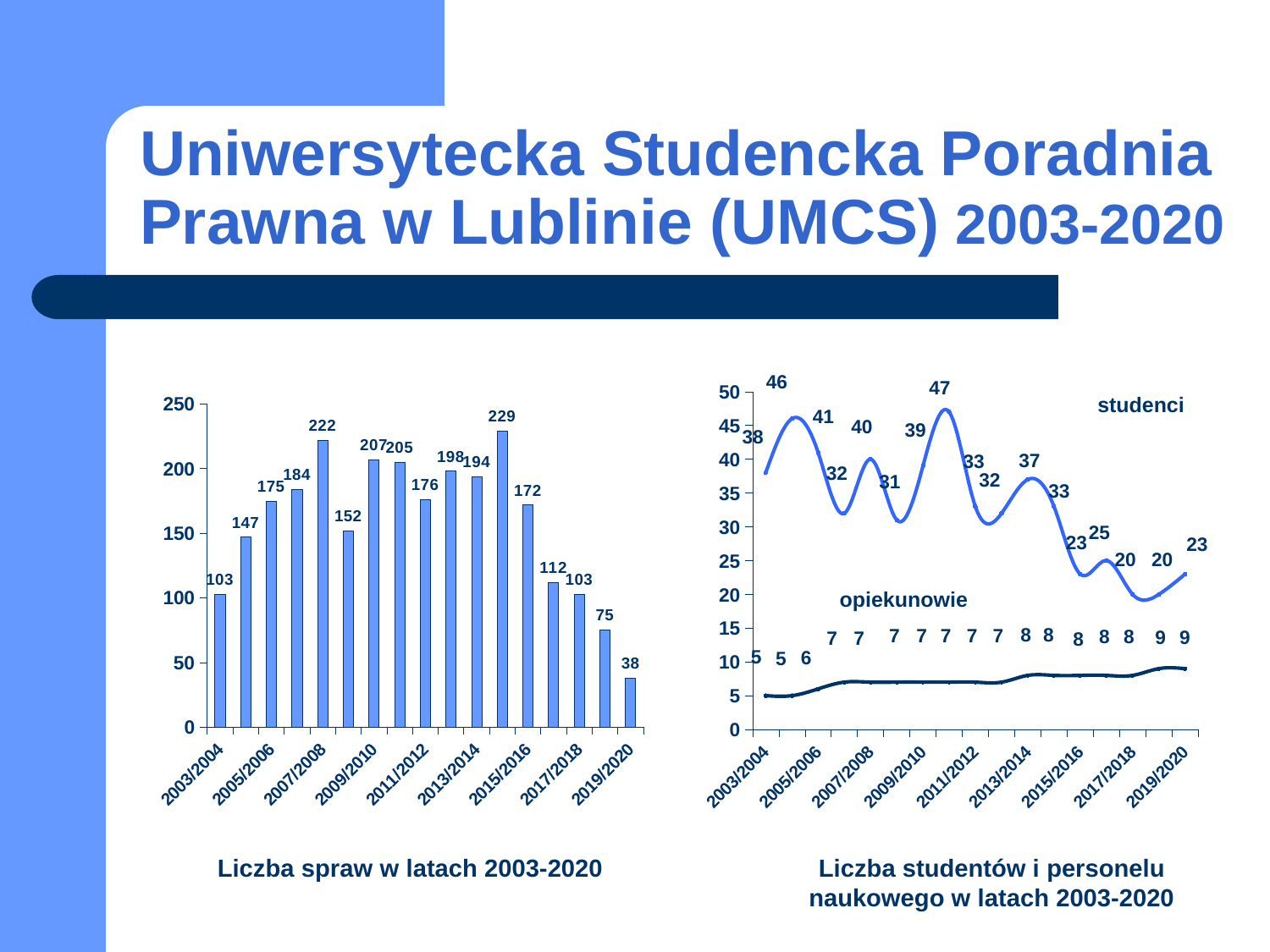
In the chart 'Liczba spraw w latach 2003-2020', what is the value for 2007/2008? 222 How many series are plotted in the chart 'Liczba studentów i personelu naukowego w latach 2003-2020'? 2 In the chart 'Liczba studentów i personelu naukowego w latach 2003-2020', what is the value of 'studenci' for 2003/2004? 38 In the chart 'Liczba spraw w latach 2003-2020', what is the value for 2003/2004? 103 In the chart 'Liczba spraw w latach 2003-2020', what is the highest value shown? 229 How many bars are in the chart 'Liczba spraw w latach 2003-2020'? 17 What kind of chart is 'Liczba spraw w latach 2003-2020'? bar chart In the chart 'Liczba studentów i personelu naukowego w latach 2003-2020', what is the highest value of 'studenci'? 47 In the chart 'Liczba spraw w latach 2003-2020', what is the difference between the values for 2007/2008 and 2019/2020? 184 In the chart 'Liczba spraw w latach 2003-2020', which year has the lowest value? 2019/2020 In the chart 'Liczba spraw w latach 2003-2020', what is the value for 2019/2020? 38 In the chart 'Liczba studentów i personelu naukowego w latach 2003-2020', which series has the larger value in 2019/2020, 'studenci' or 'opiekunowie'? studenci